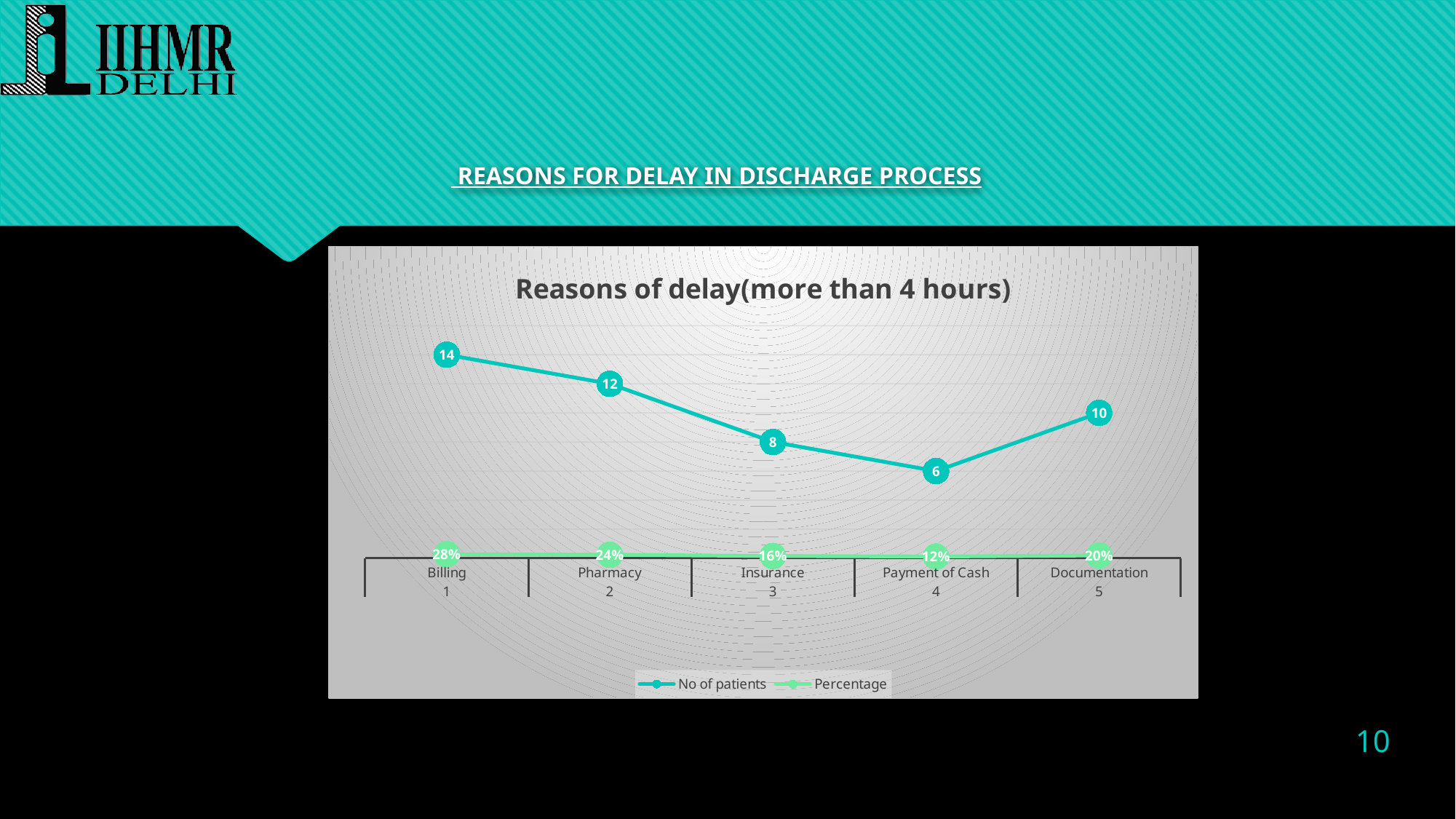
Which category has the highest number of patients? Billing What kind of chart is shown? Line chart What is the Percentage value for Documentation? 20% What is the difference in number of patients between Pharmacy and Insurance? 4 What is the title of the chart? Reasons of delay(more than 4 hours) What is the number of patients for Billing? 14 How many series does the legend list? 2 What is the number of patients for Payment of Cash? 6 How many categories are shown on the x axis? 5 What is the Percentage value for Insurance? 16% Which has more patients, Documentation or Insurance? Documentation Which category has the lowest number of patients? Payment of Cash